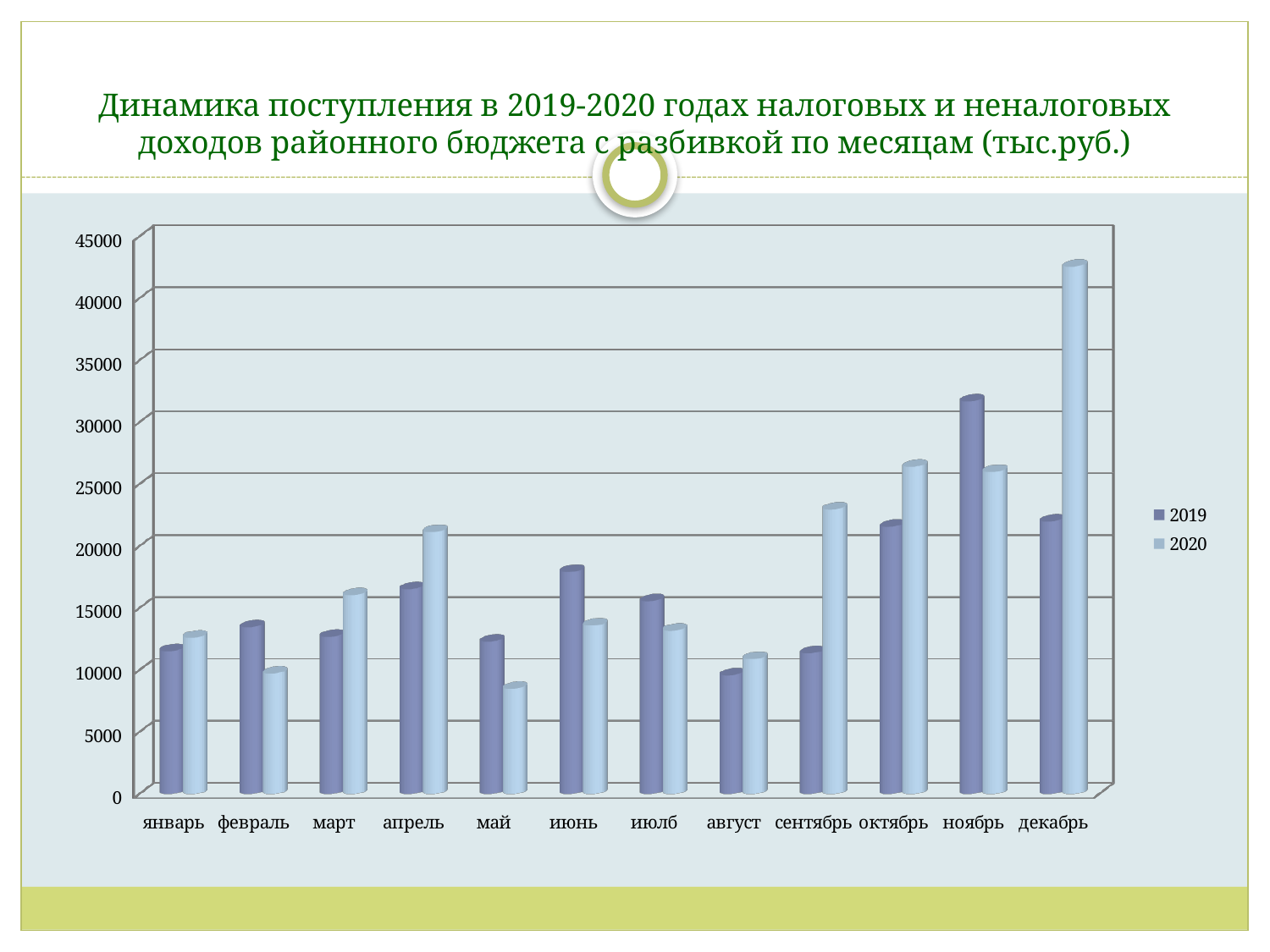
What kind of chart is shown on the slide? bar chart Is the value for декабрь in the 2020 series greater or less than 40000? greater Is the value for ноябрь in the 2019 series greater or less than 30000? greater How many months are shown along the x axis? 12 Is the value for май in the 2020 series greater or less than 10000? less Which month has the highest value for the 2020 series? декабрь Which month has the lowest value for the 2020 series? май For апрель, which series has the larger value, 2019 or 2020? 2020 What are the two entries listed in the legend? 2019 and 2020 Which month has the highest value for the 2019 series? ноябрь For ноябрь, which series has the larger value, 2019 or 2020? 2019 How many series does the legend list? 2